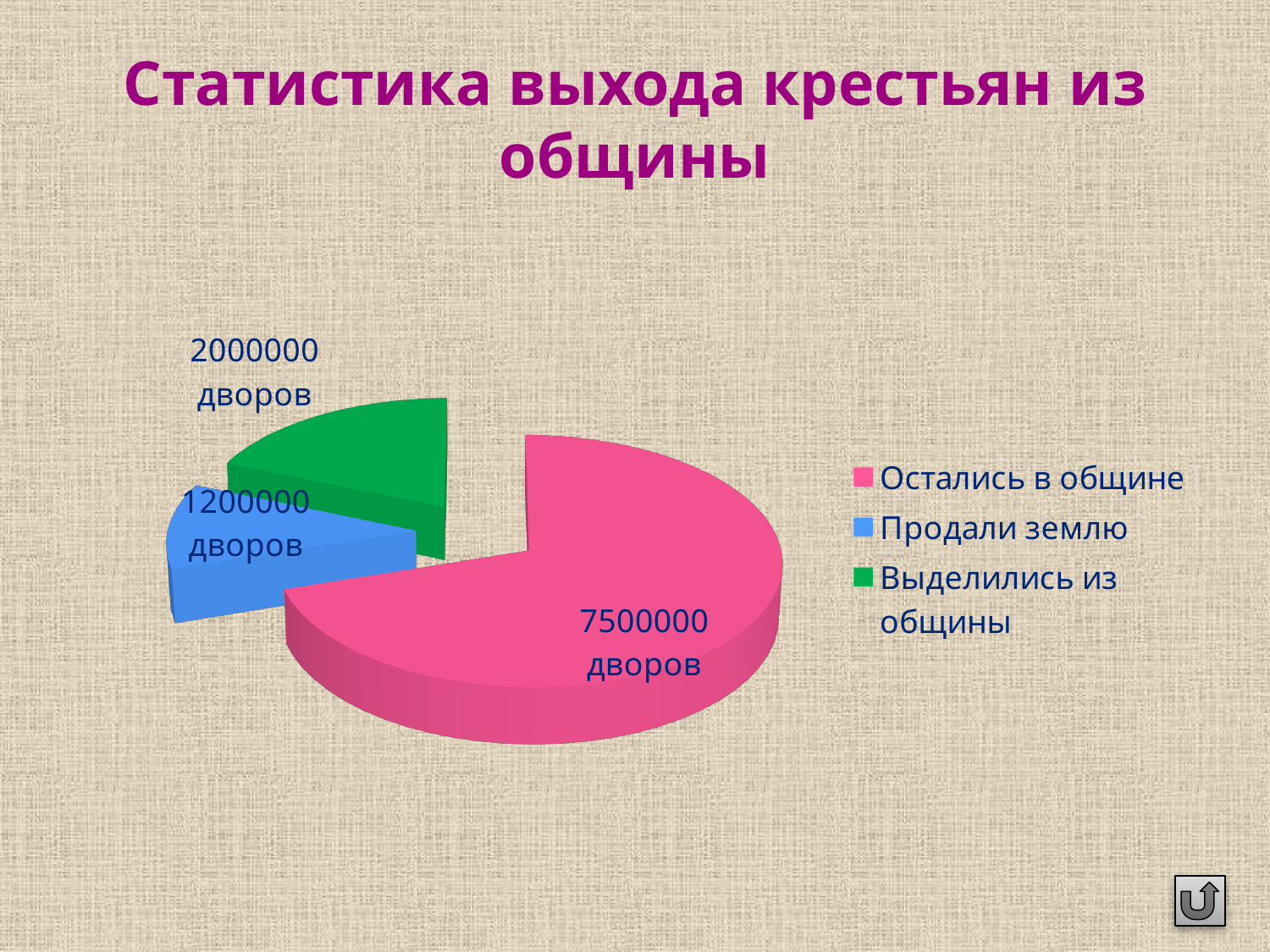
What is the title of the slide? Статистика выхода крестьян из общины What is the value for "Продали землю"? 1200000 дворов What is the value for "Остались в общине"? 7500000 дворов What is the value for "Выделились из общины"? 2000000 дворов What is the difference between "Выделились из общины" and "Продали землю"? 800000 дворов What kind of chart is shown on the slide? Pie chart What is the difference between "Остались в общине" and "Продали землю"? 6300000 дворов Which category has the smallest slice of the pie? Продали землю Which category has the largest slice of the pie? Остались в общине Which is larger: "Выделились из общины" or "Продали землю"? Выделились из общины How many categories does the pie chart have? 3 What colour is the slice for "Продали землю"? Blue